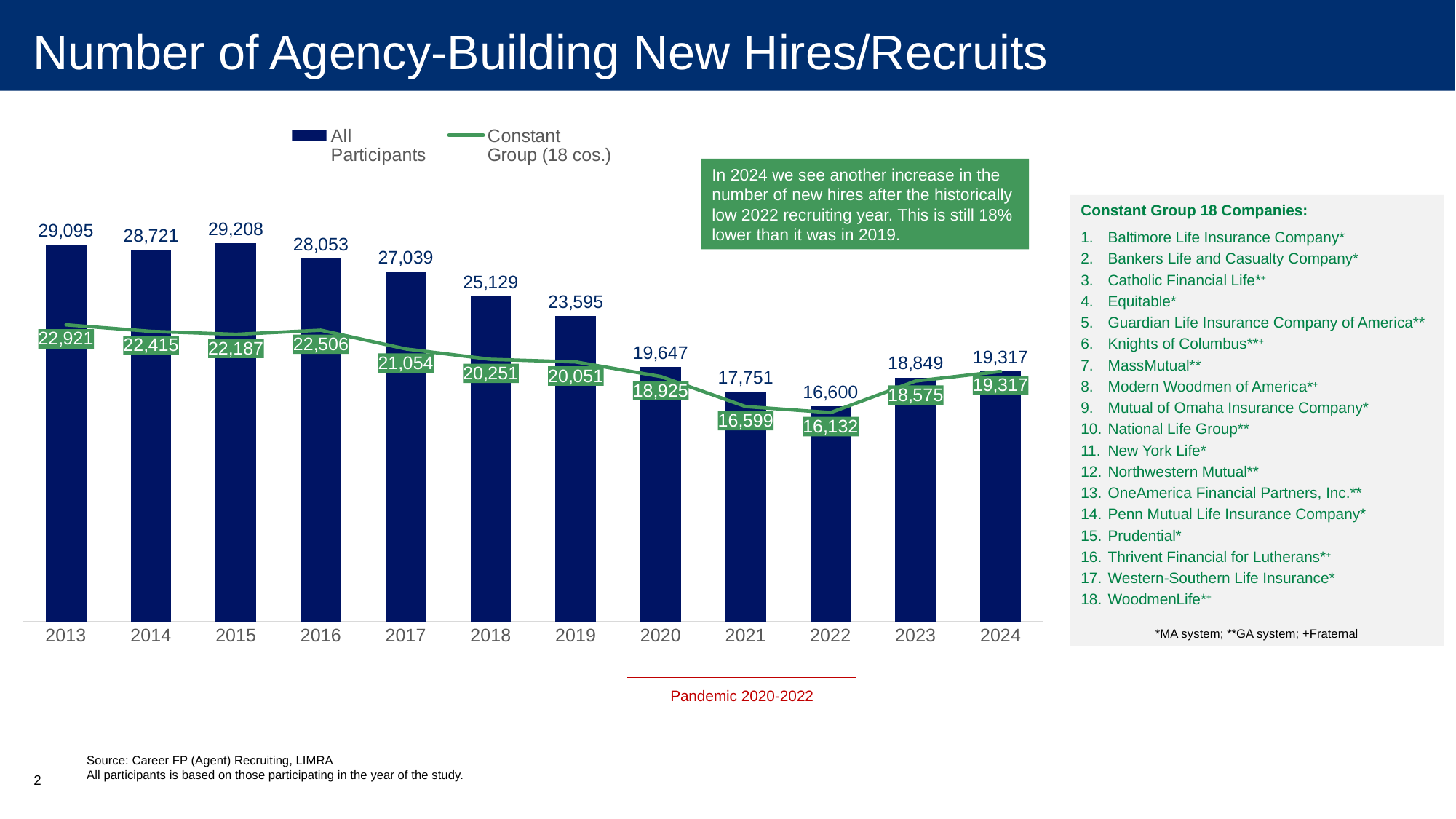
Do the All Participants values generally rise or fall from 2013 to 2022? fall In which year is the All Participants value the highest? 2015 What is the Constant Group (18 cos.) value in 2022? 16,132 How many years are shown on the x axis? 12 What is the difference between the All Participants value and the Constant Group value in 2013? 6,174 What is the value for All Participants in 2024? 19,317 What is the value for All Participants in 2019? 23,595 In which year is the All Participants value the lowest? 2022 What is the difference between the All Participants values for 2019 and 2024? 4,278 Which is larger, the All Participants value in 2023 or in 2024? 2024 In which year is the Constant Group (18 cos.) value the lowest? 2022 How many series does the legend list? 2